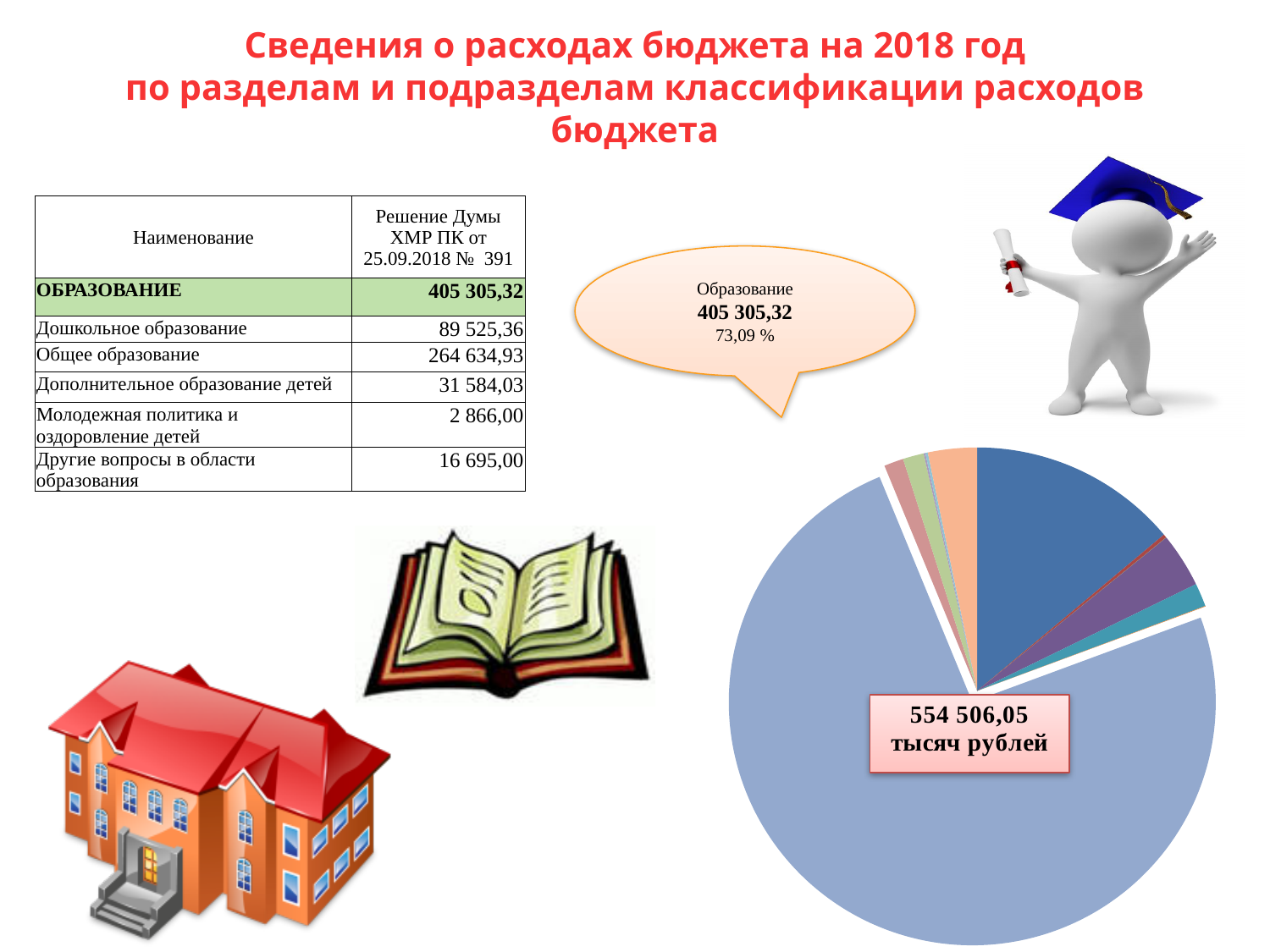
Which category does the largest slice of the pie chart represent? Образование What kind of chart is shown on the slide? pie chart What share of the pie does the Образование slice account for? 73,09 % What total is shown in the box on the pie chart? 554 506,05 тысяч рублей Does the Образование slice take up more or less than half of the pie? more Does the pie chart have a legend? No What colour is the largest slice of the pie chart? light blue What value is shown for the Образование slice in the callout on the pie chart? 405 305,32